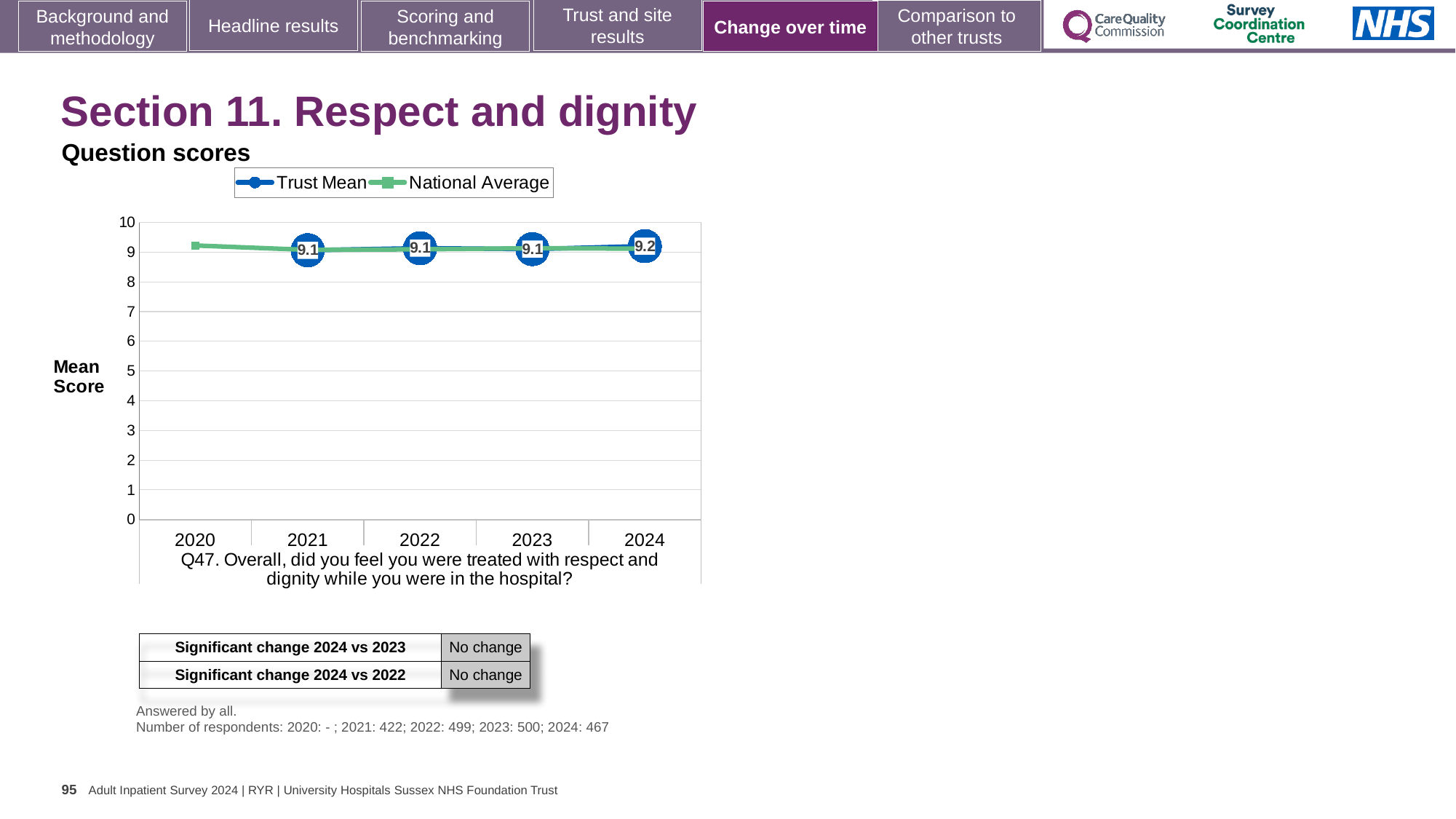
What is the label on the y axis? Mean Score How many years are shown on the x axis? 5 Does the Trust Mean rise or fall from 2021 to 2024? Rise What is the difference between the Trust Mean in 2024 and in 2021? 0.1 What is the Trust Mean value for 2023? 9.1 Is the National Average for 2020 greater or less than 8? greater How many series does the legend list? 2 In which year is the Trust Mean highest? 2024 Is the Trust Mean for 2022 greater or less than 8? greater What kind of chart is shown? Line chart What is the Trust Mean value for 2021? 9.1 What is the Trust Mean value for 2024? 9.2